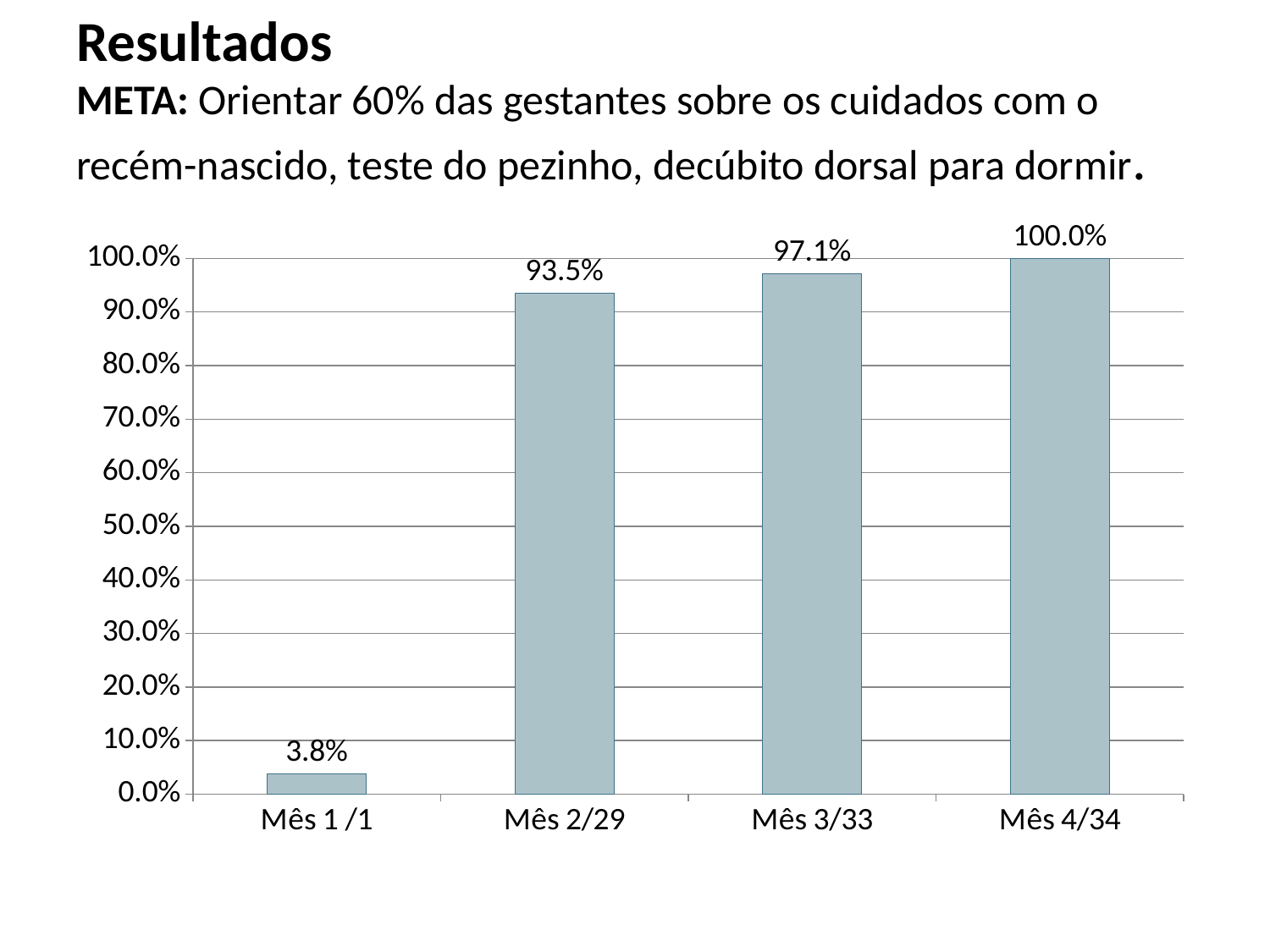
What is the difference between the values for Mês 3/33 and Mês 2/29? 3.6% What is the difference between the values for Mês 4/34 and Mês 1 /1? 96.2% Which category has the highest value? Mês 4/34 What is the value for Mês 4/34? 100.0% What is the value for Mês 3/33? 97.1% Which is larger, the value for Mês 2/29 or the value for Mês 3/33? Mês 3/33 What is the value for Mês 1 /1? 3.8% Do the values rise or fall from Mês 1 /1 to Mês 4/34? Rise What is the value for Mês 2/29? 93.5% What kind of chart is shown on the slide? Bar chart Which category has the lowest value? Mês 1 /1 How many categories are shown on the x axis? 4